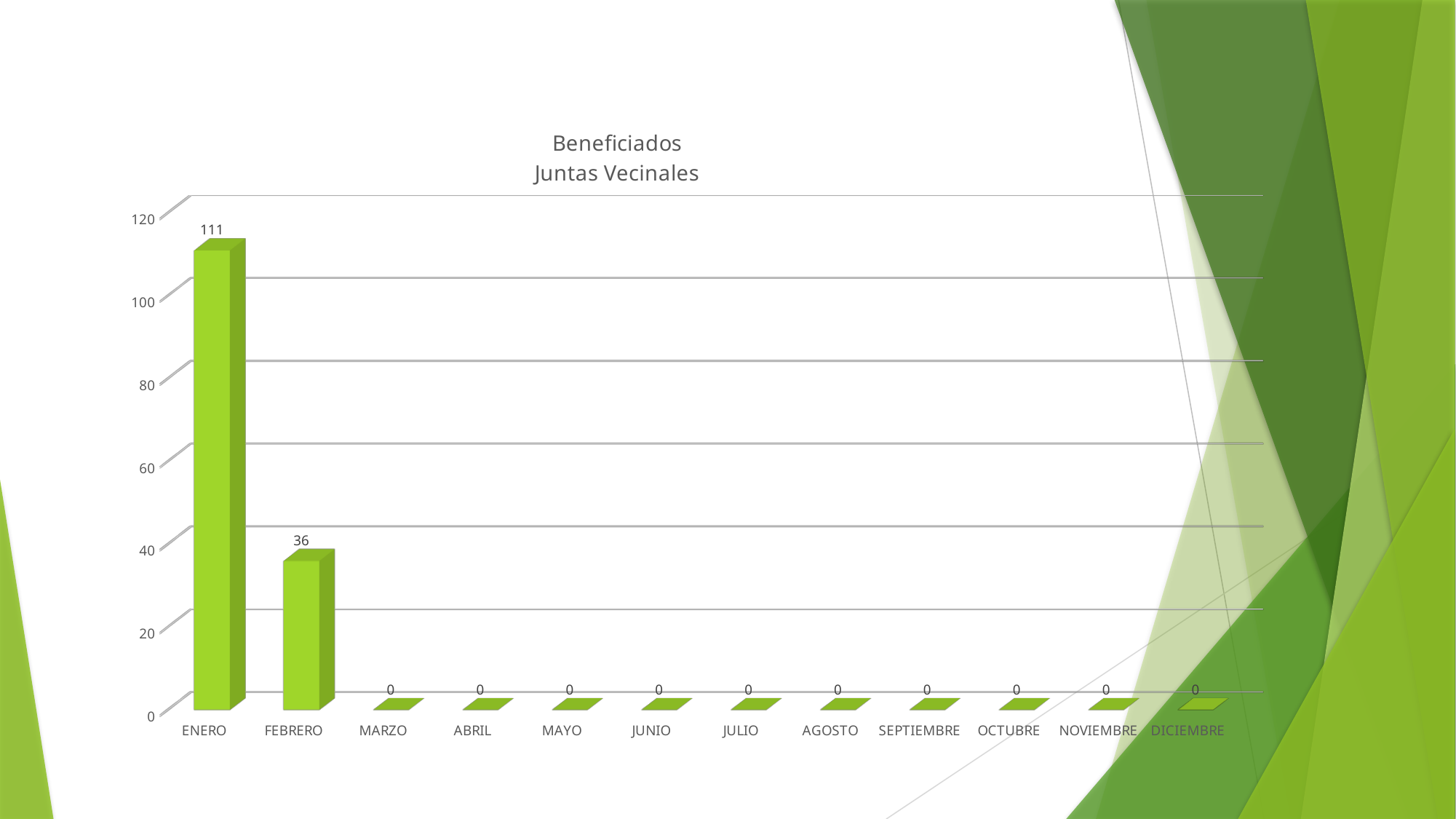
Is the value for FEBRERO greater or less than 40? less What is the value for MARZO? 0 What is the value for FEBRERO? 36 What is the title of the chart? Beneficiados Juntas Vecinales What is the difference between the values for ENERO and FEBRERO? 75 Is the value for ENERO greater or less than 100? greater Which is larger, the value for ENERO or the value for FEBRERO? ENERO Do the values rise or fall from ENERO to MARZO? fall What is the value for ENERO? 111 What kind of chart is shown? bar chart Which month has the highest value? ENERO How many months are shown on the x axis? 12